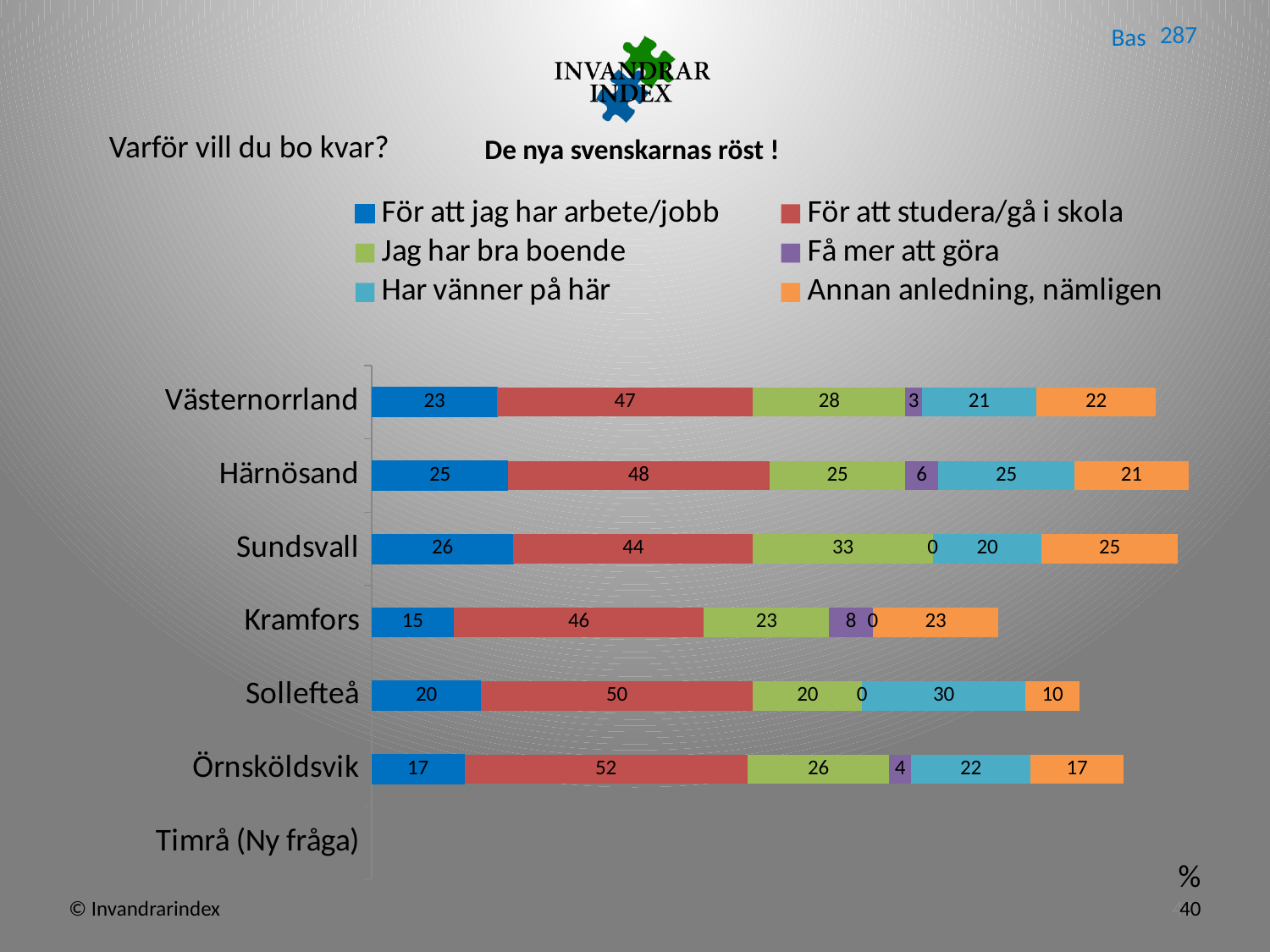
What kind of chart is shown on the slide? stacked bar chart What is the difference between the 'Annan anledning, nämligen' values for Sundsvall and Sollefteå? 15 What is the value for 'För att studera/gå i skola' for Örnsköldsvik? 52 Which category has the highest value for 'För att studera/gå i skola'? Örnsköldsvik Which category on the axis has no bar plotted? Timrå (Ny fråga) How many category labels are shown on the vertical axis? 7 What is the value for 'Jag har bra boende' for Sundsvall? 33 How many series does the legend list? 6 Which is larger: the 'Jag har bra boende' value for Västernorrland or for Kramfors? Västernorrland What is the total of the stacked bar for Härnösand? 150 Which category has the lowest value for 'För att jag har arbete/jobb'? Kramfors What is the value for 'Har vänner på här' for Sollefteå? 30